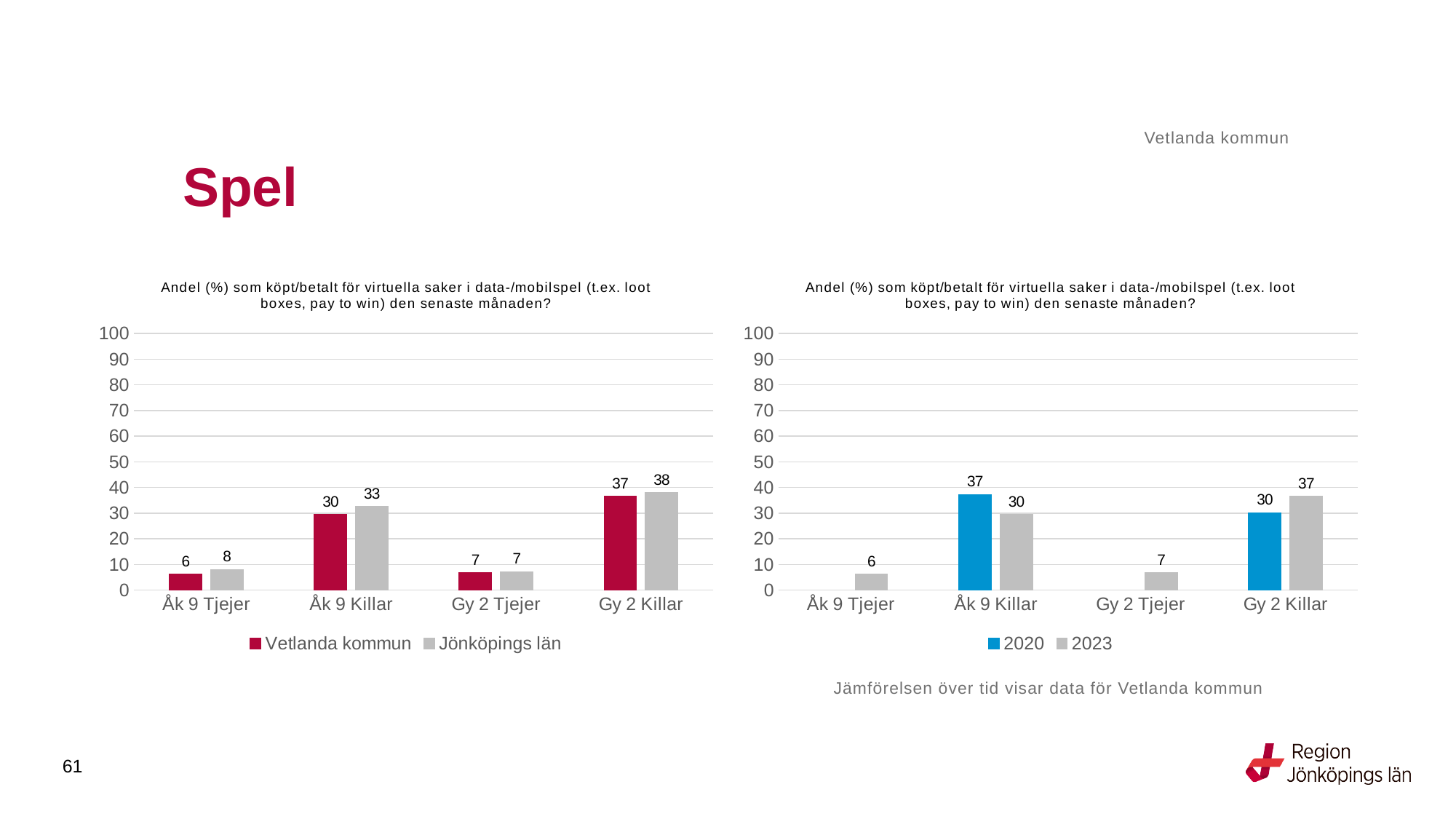
In the left chart, which category has the lowest value for Jönköpings län? Åk 9 Tjejer In the right chart, what is the difference between 2020 and 2023 for Åk 9 Killar? 7 In the left chart, what is the value for Vetlanda kommun for Åk 9 Killar? 30 In the right chart, what is the value for 2020 for Åk 9 Killar? 37 In the left chart, which category has the highest value for Vetlanda kommun? Gy 2 Killar In the left chart, how many series does the legend list? 2 How many categories are shown on the x axis of the right chart? 4 In the left chart, what is the difference between Jönköpings län and Vetlanda kommun for Åk 9 Killar? 3 In the right chart, what is the value for 2023 for Gy 2 Tjejer? 7 In the left chart, what is the value for Jönköpings län for Gy 2 Killar? 38 What type of chart is the left chart? Bar chart In the right chart, which is larger for Gy 2 Killar, 2020 or 2023? 2023